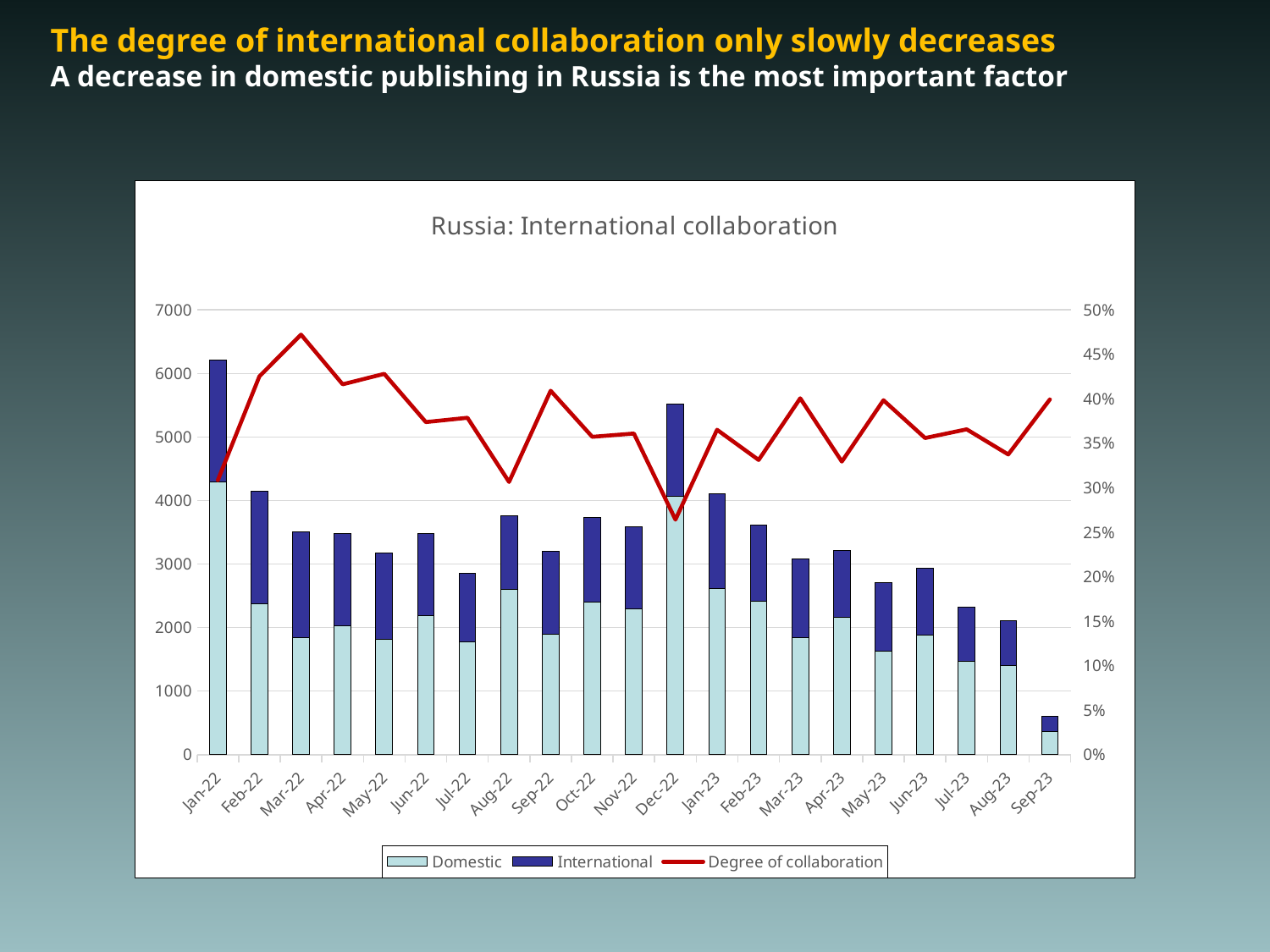
Is the total stacked bar for Jan-22 greater or less than 6000? greater How many months are shown on the x axis? 21 Which month has the shortest stacked bar (lowest total publications)? Sep-23 Which month has the tallest stacked bar (highest total publications)? Jan-22 Which month has the larger total stacked bar, Nov-22 or Dec-22? Dec-22 In which month does the Degree of collaboration line reach its lowest point? Dec-22 How many series does the legend list? 3 Is the Degree of collaboration for Dec-22 greater or less than 30%? less What is the title of the chart? Russia: International collaboration In which month does the Degree of collaboration line reach its highest point? Mar-22 What kind of chart is this? Stacked bar chart with a line Is the total stacked bar for Sep-23 greater or less than 1000? less